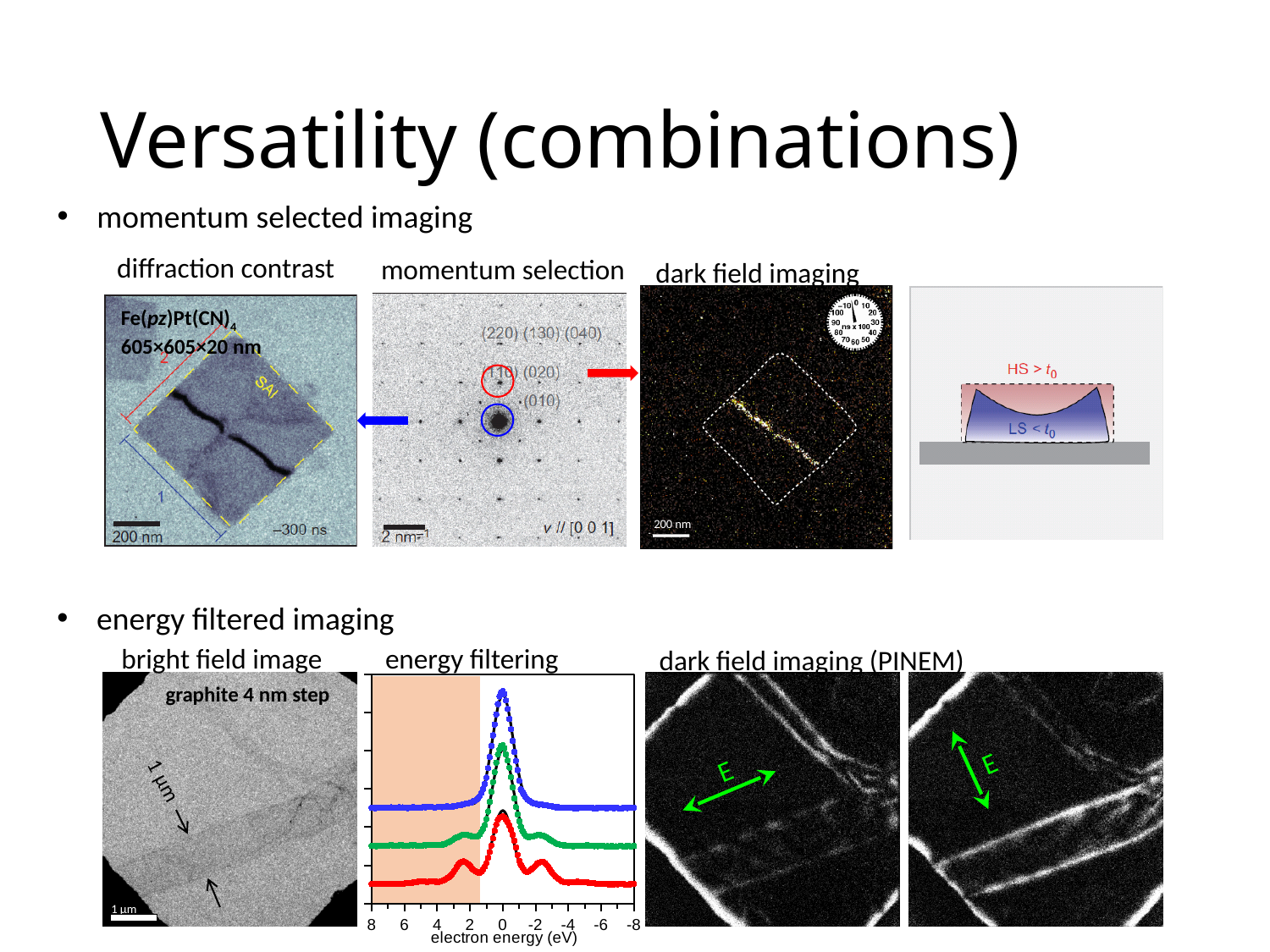
In the "energy filtering" chart, is the shaded region on the positive or negative side of 0 eV? positive What is the largest value shown on the x axis of the "energy filtering" chart? 8 What colours are the three curves in the "energy filtering" chart? blue, green and red How many curves are plotted in the "energy filtering" chart? 3 What kind of chart is the "energy filtering" plot? line chart What is the x-axis label of the "energy filtering" chart? electron energy (eV) In the "energy filtering" chart, which curve is drawn at the bottom of the plot? red In the "energy filtering" chart, which curve is drawn at the top of the plot? blue What is the smallest value shown on the x axis of the "energy filtering" chart? -8 At what electron energy value on the x axis do the curves in the "energy filtering" chart reach their main peak? 0